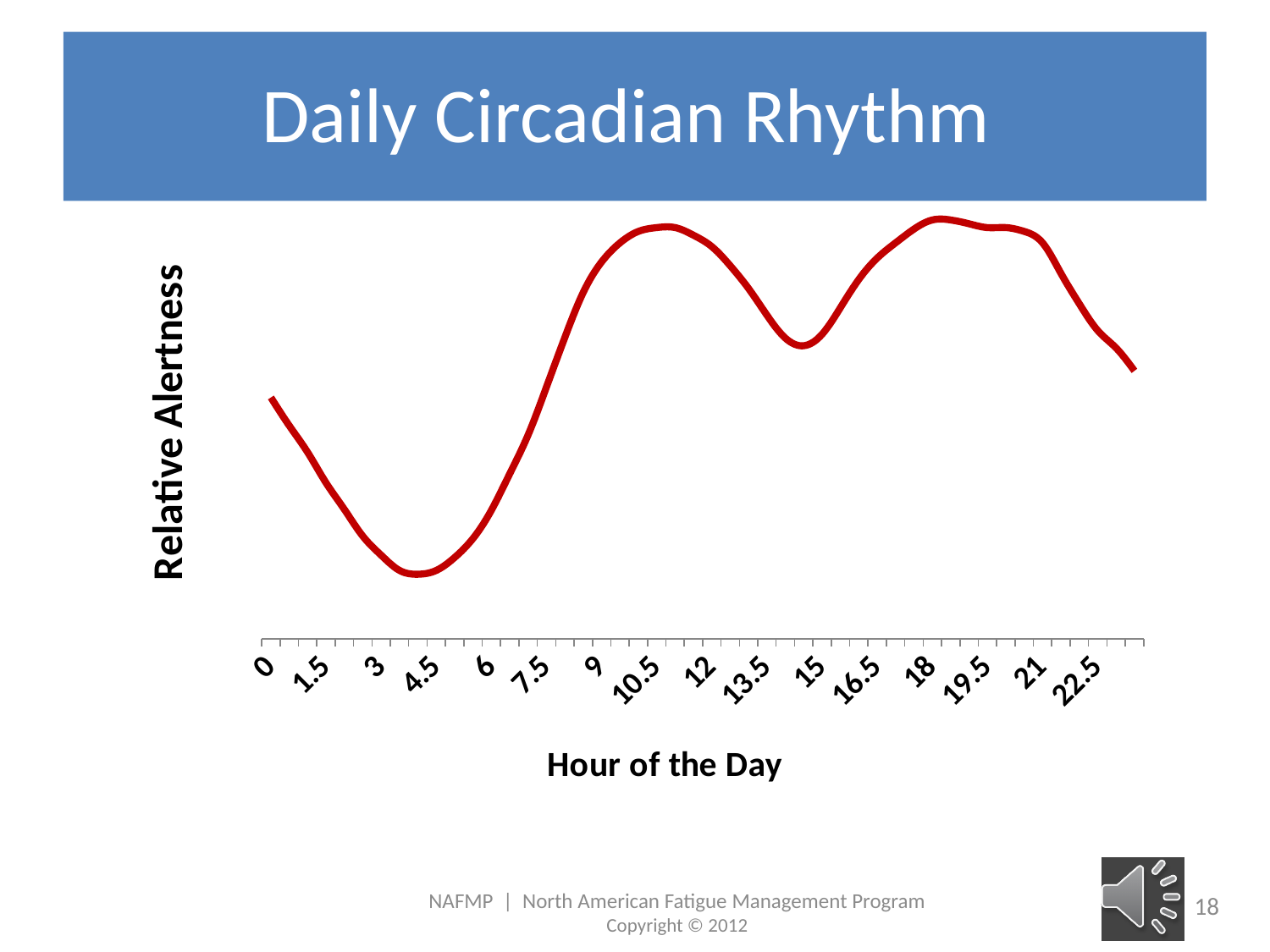
Does relative alertness rise or fall between hour 21 and hour 22.5? fall Does relative alertness rise or fall between hour 0 and hour 4.5? fall Which has higher relative alertness, hour 4.5 or hour 10.5? 10.5 Around which labelled hour of the day is relative alertness at its lowest? 4.5 Which has higher relative alertness, hour 3 or hour 22.5? 22.5 Does relative alertness rise or fall between hour 4.5 and hour 10.5? rise Which has higher relative alertness, hour 0 or hour 15? 15 What is the title of the chart? Daily Circadian Rhythm How many hour labels are shown along the x axis? 16 What is the label on the x axis of the chart? Hour of the Day What kind of chart is shown on the slide? line chart